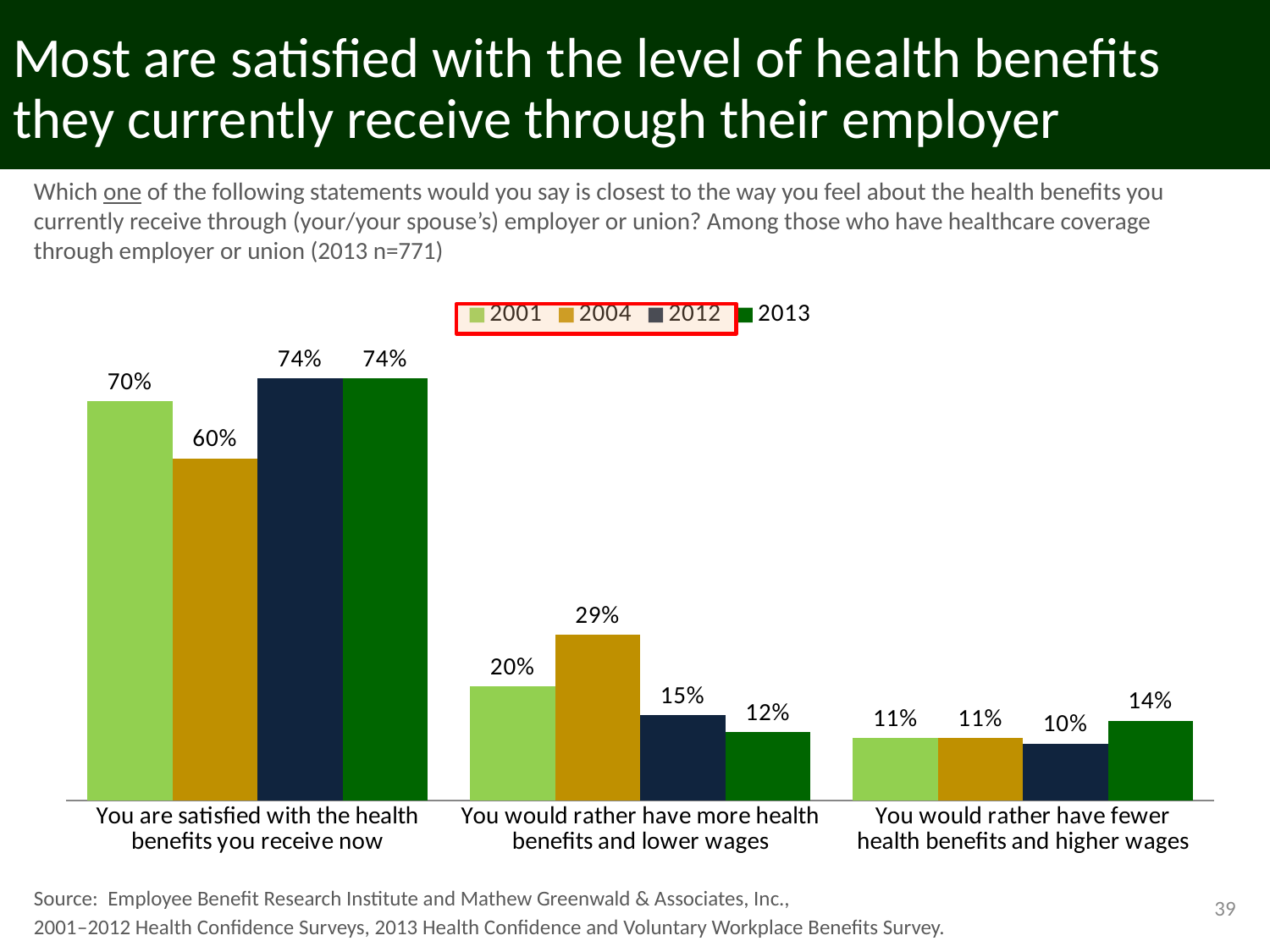
What type of chart is shown on the slide? Bar chart Which year had the highest share saying they would rather have more health benefits and lower wages? 2004 What was the 2004 value for 'You would rather have more health benefits and lower wages'? 29% What was the 2012 value for 'You would rather have fewer health benefits and higher wages'? 10% What is the difference between the 2001 and 2004 values for 'You are satisfied with the health benefits you receive now'? 10% How many series does the legend list? 4 What percentage of respondents in 2013 said they are satisfied with the health benefits they receive now? 74% Which years are listed in the chart legend? 2001, 2004, 2012, 2013 Which is larger: the 2013 value for 'rather have more health benefits and lower wages' or the 2013 value for 'rather have fewer health benefits and higher wages'? Rather have fewer health benefits and higher wages (14%) Which year had the lowest share saying they are satisfied with the health benefits they receive now? 2004 By how much did the share wanting more health benefits and lower wages fall from 2004 to 2013? 17% How many statement categories are shown on the x axis? 3